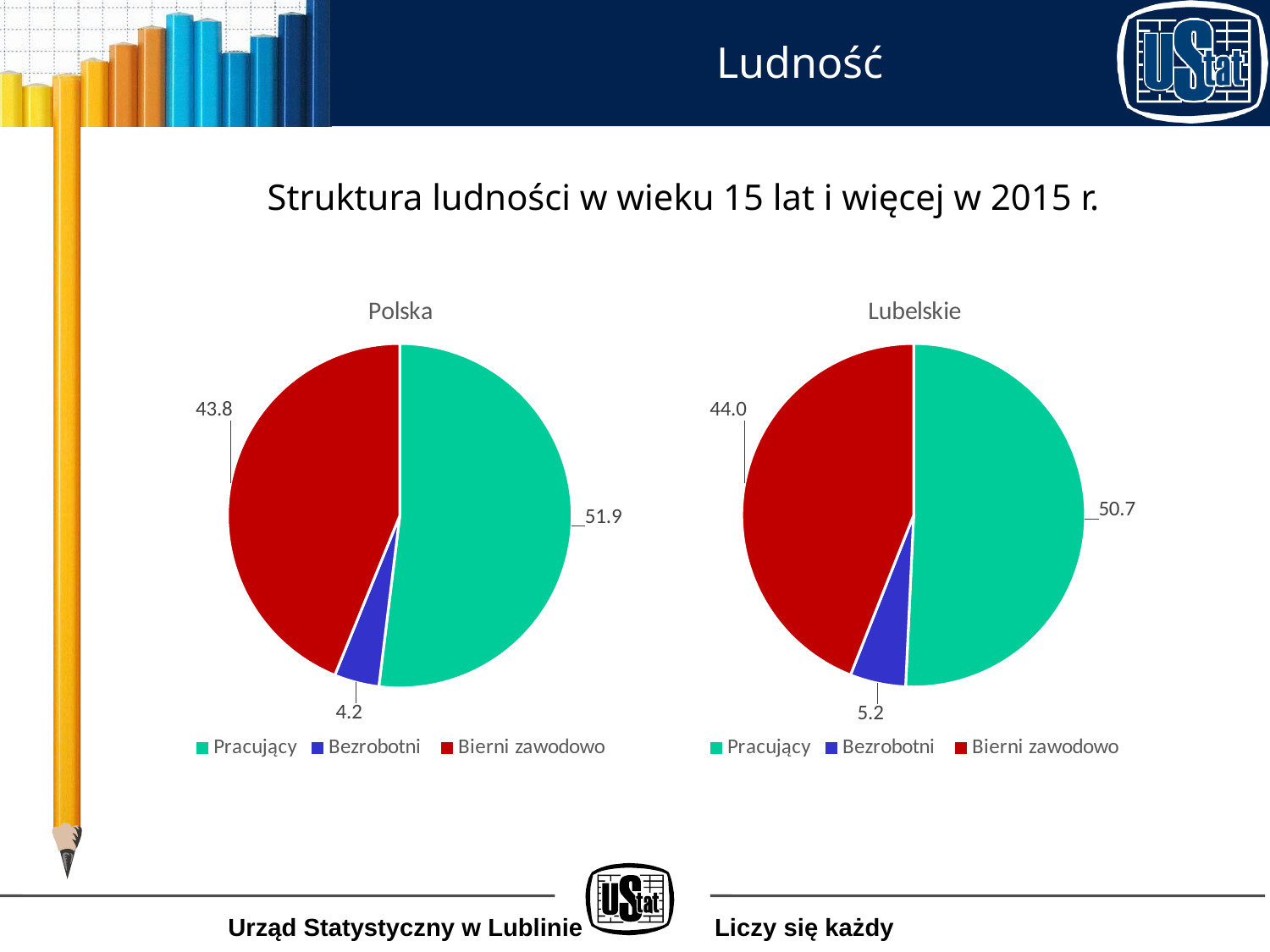
How many slices does the Lubelskie pie chart have? 3 How many entries does the legend of the Polska chart list? 3 In the Lubelskie pie chart, which category has the largest slice? Pracujący In the Lubelskie pie chart, what is the value for Bierni zawodowo? 44.0 In the Lubelskie pie chart, what colour is the Bierni zawodowo slice? Red In the Polska pie chart, which category has the smallest slice? Bezrobotni Which is larger: the Bezrobotni value in the Polska chart or the Bezrobotni value in the Lubelskie chart? Lubelskie In the Polska pie chart, what is the value for Pracujący? 51.9 What type of chart is used for Polska and Lubelskie? Pie chart In the Lubelskie pie chart, what is the value for Bezrobotni? 5.2 In the Polska pie chart, what is the difference between the values for Pracujący and Bierni zawodowo? 8.1 In the Polska pie chart, what is the value for Bierni zawodowo? 43.8